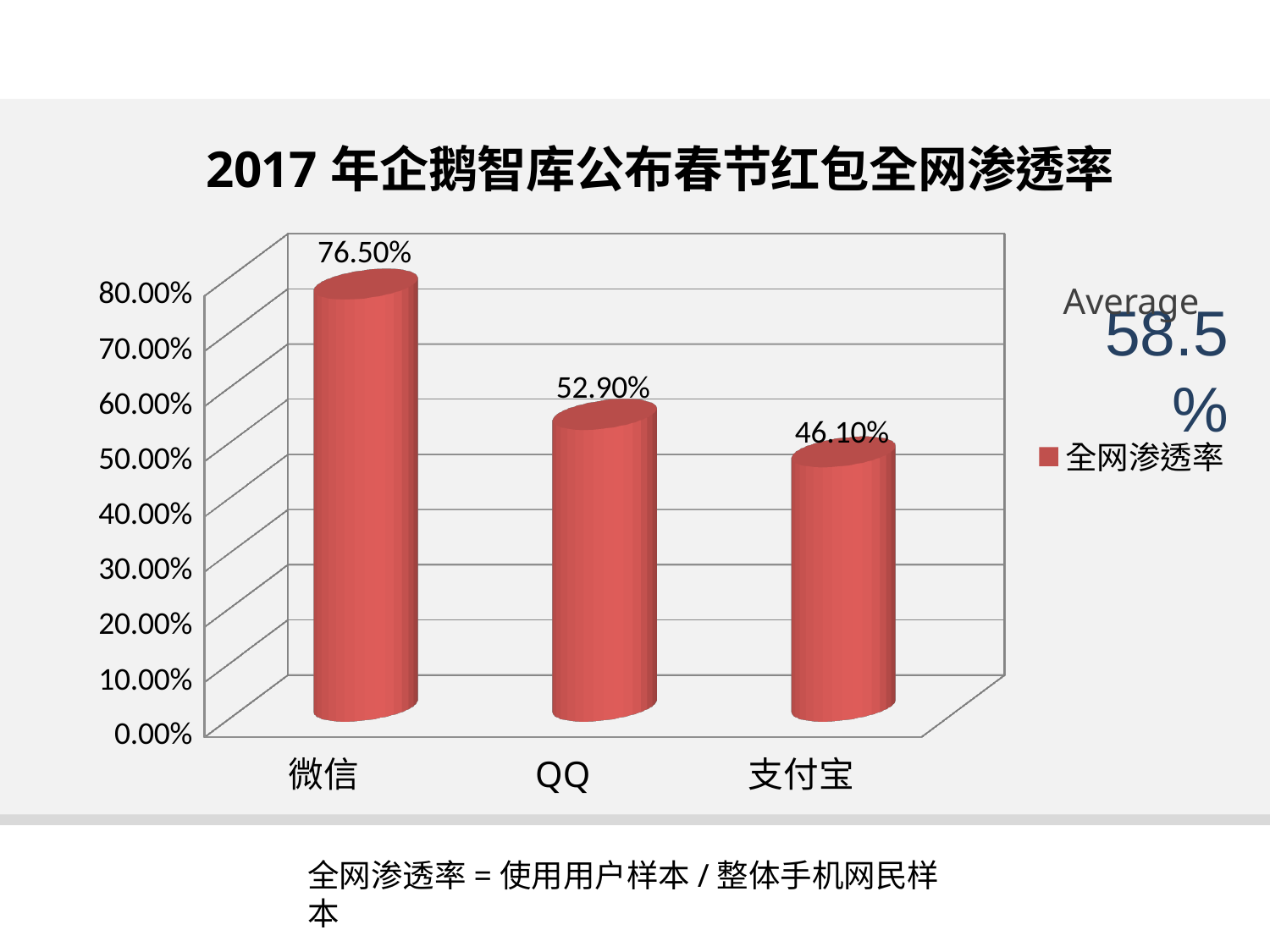
What is the title of the chart? 2017 年企鹅智库公布春节红包全网渗透率 What is the difference between the values for QQ and 支付宝? 6.80% What is the value for 支付宝? 46.10% Which category has the lowest value? 支付宝 What kind of chart is shown on the slide? bar chart Which category has the highest value? 微信 What is the value for 微信? 76.50% Which is larger, the value for QQ or the value for 支付宝? QQ What is the difference between the values for 微信 and QQ? 23.60% How many series does the legend list? 1 What is the value for QQ? 52.90% How many categories are shown on the x axis? 3